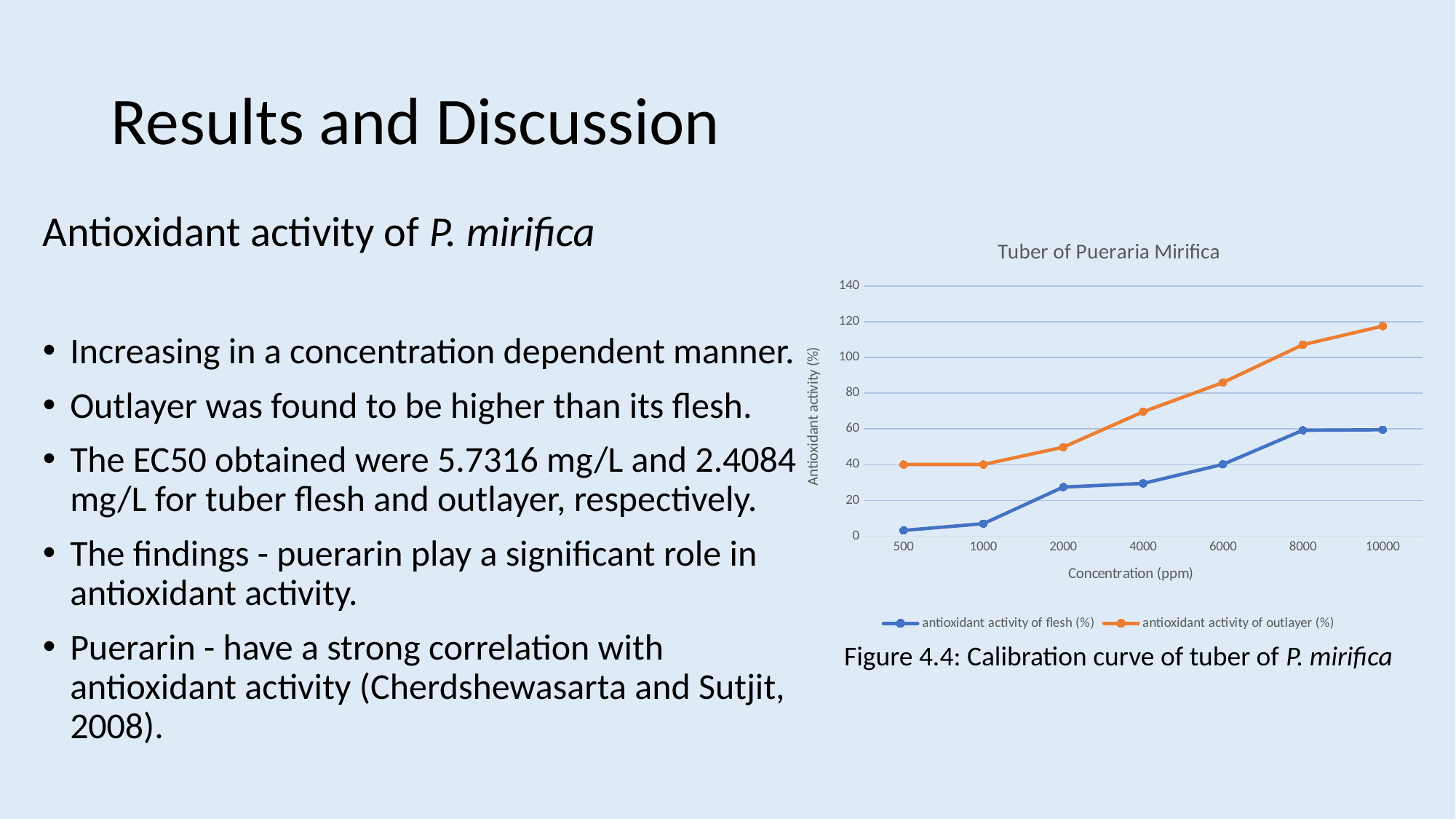
Is the antioxidant activity of flesh (%) at 500 ppm greater or less than 20? less At 10000 ppm, which series has the larger value: antioxidant activity of flesh (%) or antioxidant activity of outlayer (%)? antioxidant activity of outlayer (%) What is the title of the chart? Tuber of Pueraria Mirifica How many concentration points are plotted along the x axis of the chart? 7 What kind of chart is shown on the slide? line chart How many series does the legend of the chart list? 2 Is the antioxidant activity of flesh (%) at 8000 ppm greater or less than 80? less Does the antioxidant activity of outlayer (%) rise or fall as concentration increases along the x axis? rise Is the antioxidant activity of outlayer (%) at 10000 ppm greater or less than 100? greater Which series is shown in orange in the chart? antioxidant activity of outlayer (%) At which concentration is the antioxidant activity of outlayer (%) highest? 10000